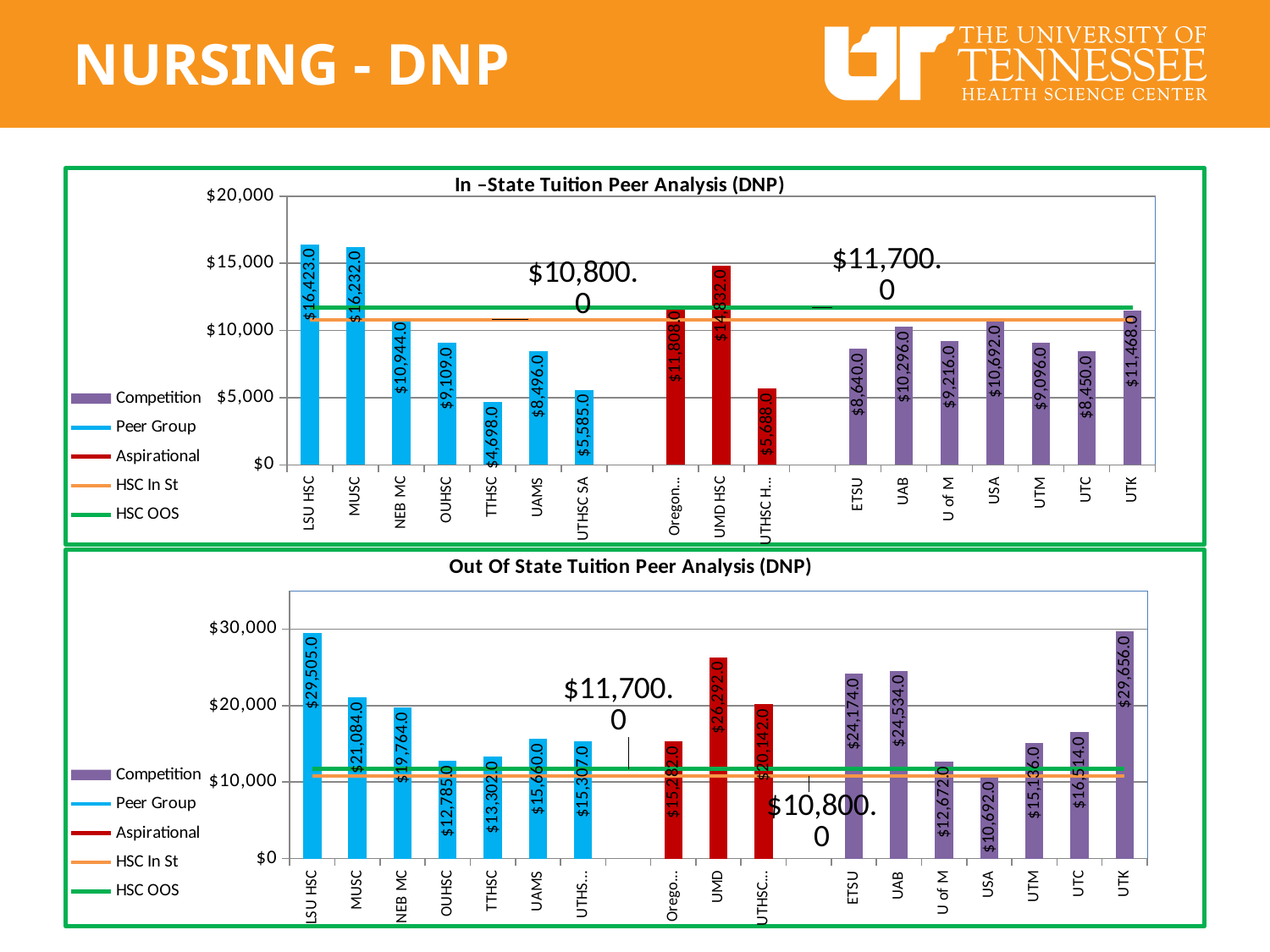
In the Out Of State Tuition Peer Analysis (DNP) chart, which is larger, the tuition for UAB or the tuition for ETSU? UAB In the In-State Tuition Peer Analysis (DNP) chart, what is the difference between the tuition for UAB and the tuition for ETSU? $1,656.0 In the In-State Tuition Peer Analysis (DNP) chart, which institution has the lowest in-state tuition? TTHSC In the Out Of State Tuition Peer Analysis (DNP) chart, what is the difference between the tuition for UTK and the tuition for LSU HSC? $151.0 In the In-State Tuition Peer Analysis (DNP) chart, what value is shown for the HSC OOS line? $11,700.0 In the Out Of State Tuition Peer Analysis (DNP) chart, is the value for LSU HSC greater or less than $20,000? greater How many entries does the legend of the In-State Tuition Peer Analysis (DNP) chart list? 5 In the Out Of State Tuition Peer Analysis (DNP) chart, which institution has the lowest out-of-state tuition? USA What type of chart is the Out Of State Tuition Peer Analysis (DNP) chart? Bar chart In the In-State Tuition Peer Analysis (DNP) chart, what is the in-state tuition for NEB MC? $10,944.0 In the In-State Tuition Peer Analysis (DNP) chart, which institution has the highest in-state tuition? LSU HSC In the Out Of State Tuition Peer Analysis (DNP) chart, what is the out-of-state tuition for UMD? $26,292.0